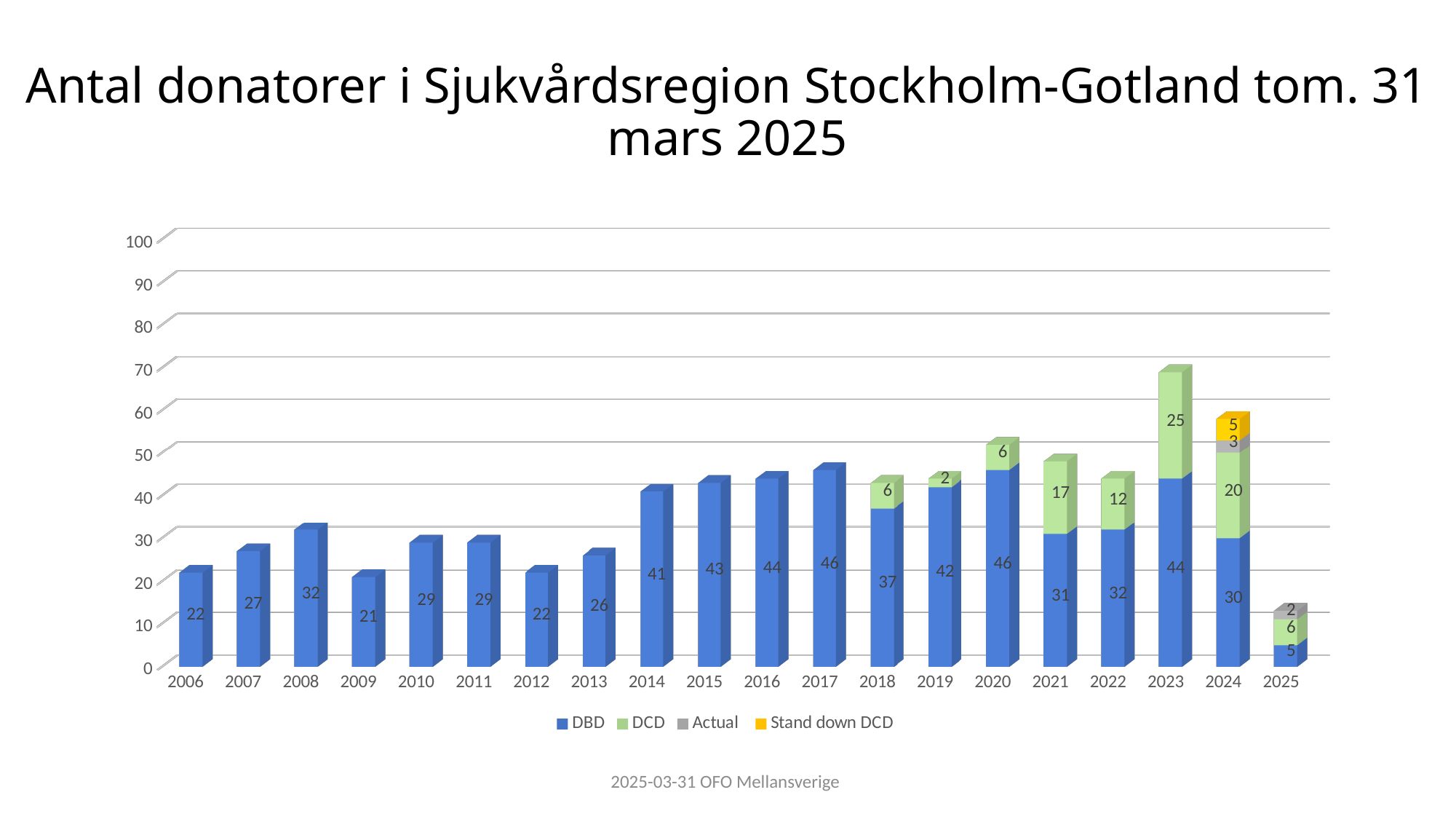
What type of chart is shown on the slide? stacked bar chart How many series does the legend list? 4 Which year has the highest DCD value? 2023 How many years are shown on the x axis? 20 What is the DBD value for 2008? 32 What is the Stand down DCD value for 2024? 5 What is the difference between the DBD values for 2017 and 2018? 9 What is the total of the stacked bar for 2024? 58 Which is larger, the DBD value for 2014 or the DBD value for 2021? 2014 Which year has the tallest stacked bar overall? 2023 Which year has the lowest DBD value? 2025 What is the DCD value for 2021? 17